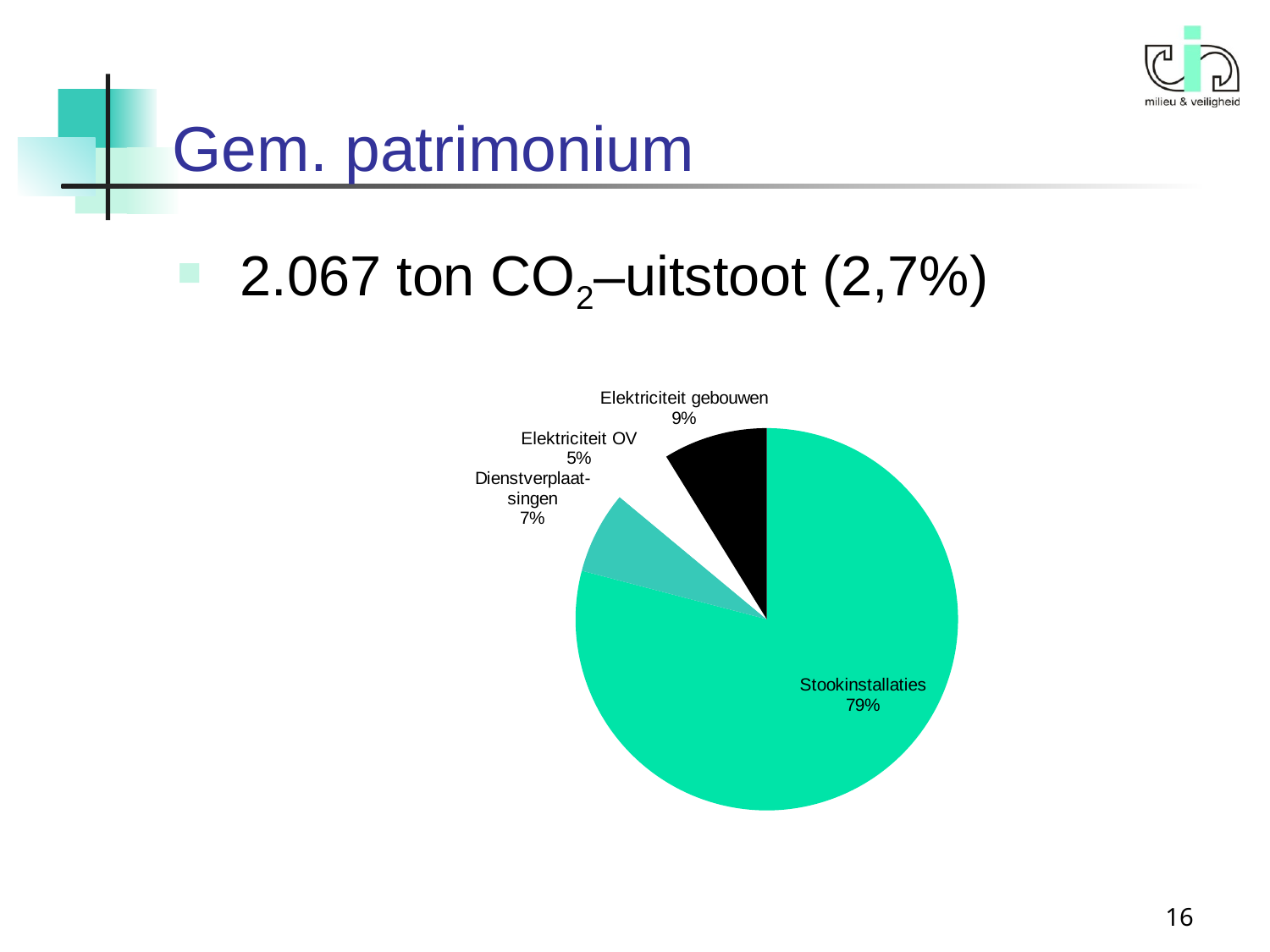
How many slices does the pie chart have? 4 What kind of chart is shown on the slide? pie chart What share of the pie does Stookinstallaties have? 79% What colour is the Elektriciteit gebouwen slice of the pie chart? black What share of the pie does Elektriciteit OV have? 5% What share of the pie does Elektriciteit gebouwen have? 9% Which slice of the pie chart is the smallest? Elektriciteit OV Which slice of the pie chart is the largest? Stookinstallaties What is the difference in percentage points between Dienstverplaatsingen and Elektriciteit OV? 2 What is the difference in percentage points between Stookinstallaties and Elektriciteit gebouwen? 70 Which is larger, the share for Elektriciteit gebouwen or the share for Dienstverplaatsingen? Elektriciteit gebouwen